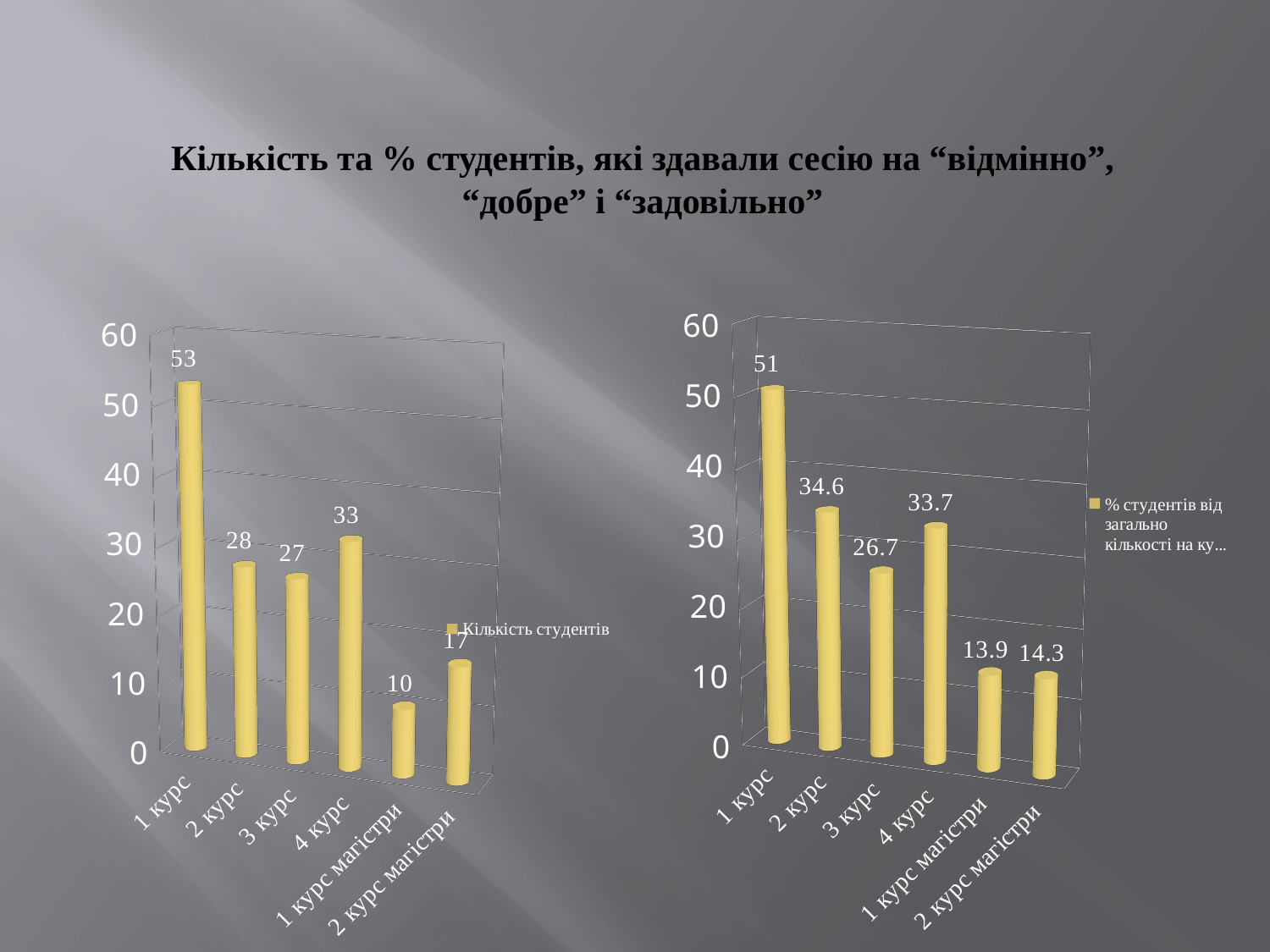
In the right chart, which is larger, the value for 3 курс or the value for 4 курс? 4 курс In the right chart, what is the value for 2 курс? 34.6 What kind of chart is the left chart (Кількість студентів)? Bar chart In the right chart, what is the difference between the values for 1 курс and 2 курс? 16.4 In the left chart (Кількість студентів), which category has the lowest value? 1 курс магістри In the right chart, which category has the highest value? 1 курс In the left chart (Кількість студентів), what is the value for 1 курс? 53 In the left chart (Кількість студентів), what is the value for 1 курс магістри? 10 In the left chart (Кількість студентів), how many categories are shown on the x axis? 6 In the left chart (Кількість студентів), which category has the highest value? 1 курс In the right chart, what is the value for 1 курс магістри? 13.9 In the left chart (Кількість студентів), what is the difference between the values for 4 курс and 2 курс магістри? 16